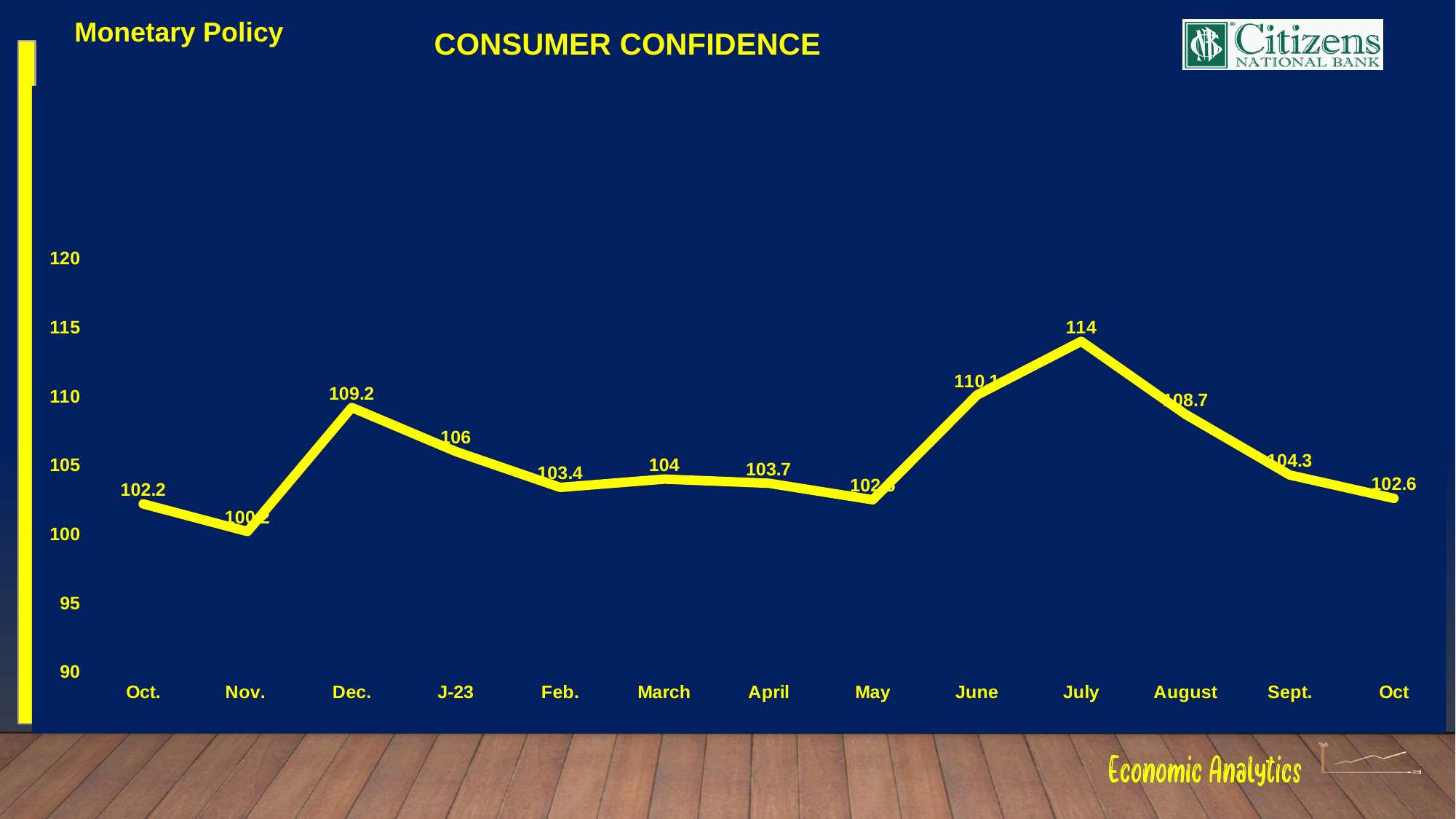
Which is larger, the value for Dec. or the value for J-23? Dec. What is the consumer confidence value for Dec.? 109.2 What is the consumer confidence value for July? 114 What kind of chart is shown on the slide? line chart Which month has the lowest consumer confidence value? Nov. Does the consumer confidence value rise or fall from Dec. to May? fall What is the consumer confidence value for Sept.? 104.3 What is the difference between the July value and the Dec. value? 4.8 What is the consumer confidence value for Feb.? 103.4 Which month has the highest consumer confidence value? July Is the value for August greater or less than 105? greater How many months are plotted on the chart? 13